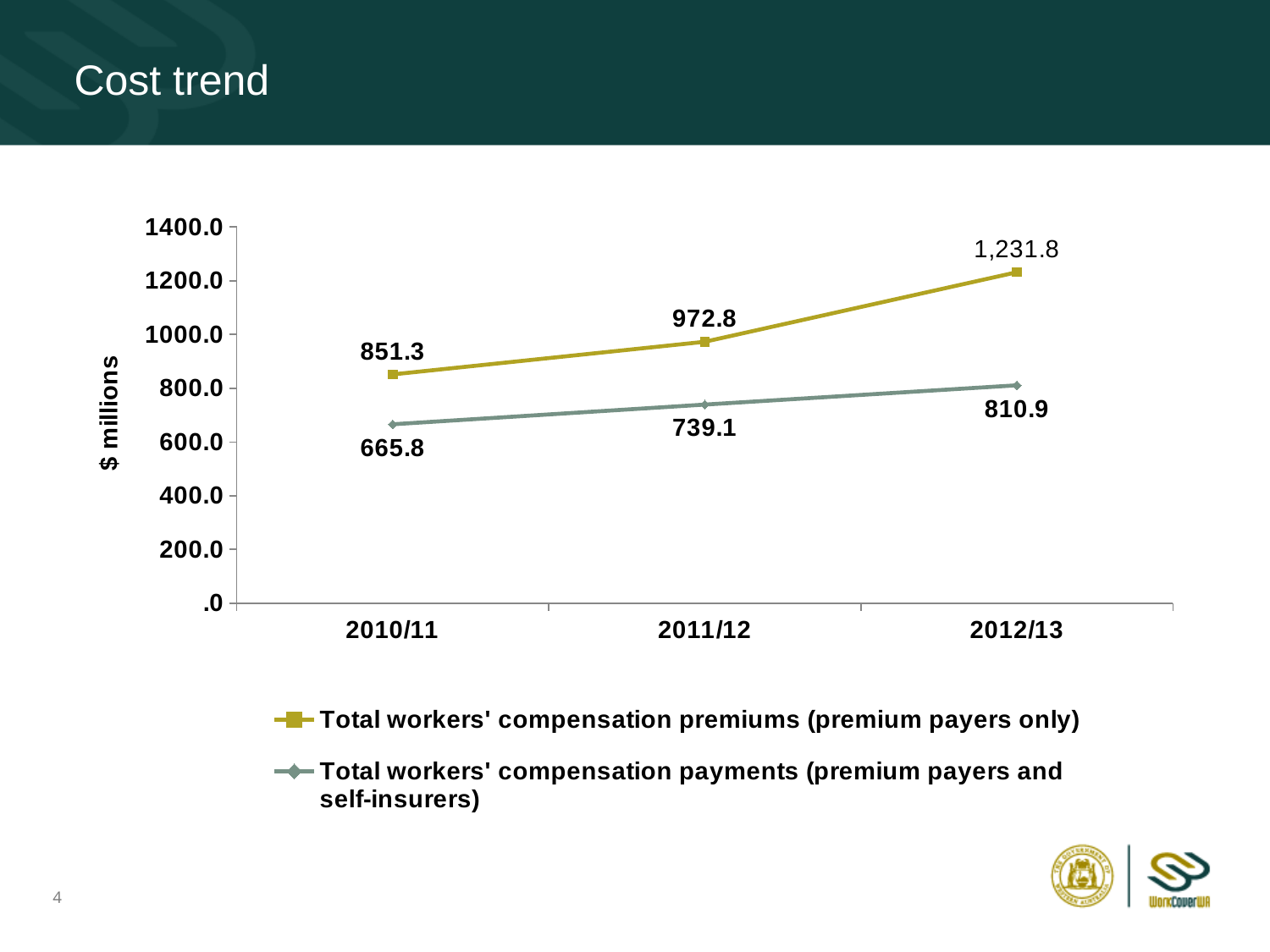
What is the value of Total workers' compensation payments (premium payers and self-insurers) in 2012/13? 810.9 Which is larger in 2010/11: Total workers' compensation premiums or Total workers' compensation payments? Total workers' compensation premiums How many series does the legend list? 2 In which year is Total workers' compensation payments (premium payers and self-insurers) lowest? 2010/11 How many years are shown on the x axis? 3 What is the value of Total workers' compensation premiums (premium payers only) in 2012/13? 1,231.8 In which year is Total workers' compensation premiums (premium payers only) highest? 2012/13 What is the value of Total workers' compensation payments (premium payers and self-insurers) in 2010/11? 665.8 What kind of chart is shown on the slide? Line chart Do the values for Total workers' compensation premiums (premium payers only) rise or fall from 2010/11 to 2012/13? Rise What is the difference between Total workers' compensation premiums and Total workers' compensation payments in 2011/12? 233.7 What is the value of Total workers' compensation premiums (premium payers only) in 2011/12? 972.8